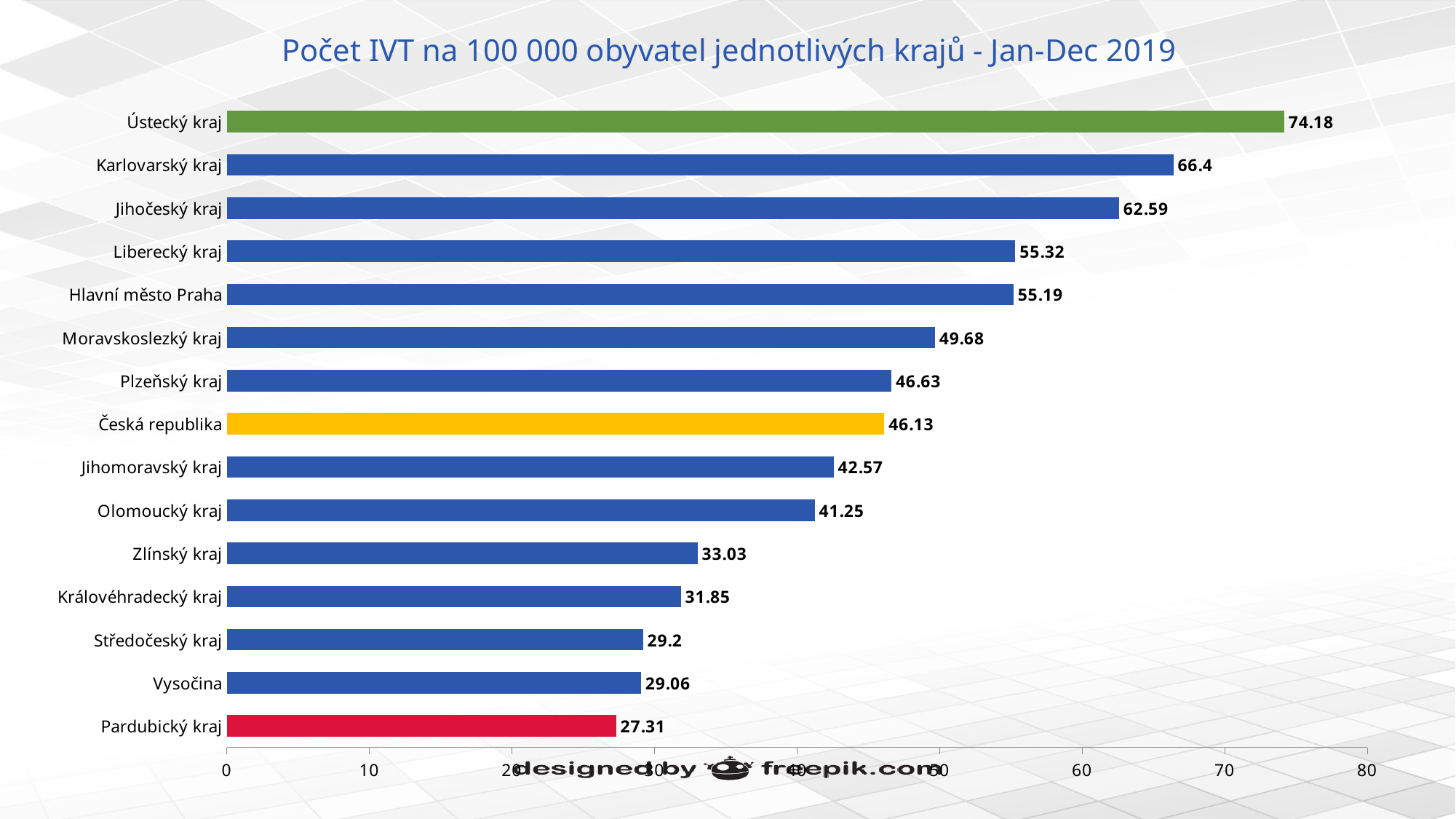
How many bars are shown in the chart? 15 Is the value for Moravskoslezský kraj greater or less than 50? less What is the value for Ústecký kraj? 74.18 What type of chart is shown on the slide? bar chart What is the value for Hlavní město Praha? 55.19 What is the title of the chart? Počet IVT na 100 000 obyvatel jednotlivých krajů - Jan-Dec 2019 Which has a larger value, Zlínský kraj or Olomoucký kraj? Olomoucký kraj Which region has the lowest value? Pardubický kraj Which region has the highest value? Ústecký kraj What is the difference between the values for Ústecký kraj and Pardubický kraj? 46.87 What is the difference between the values for Karlovarský kraj and Jihočeský kraj? 3.81 What is the value shown for Česká republika? 46.13